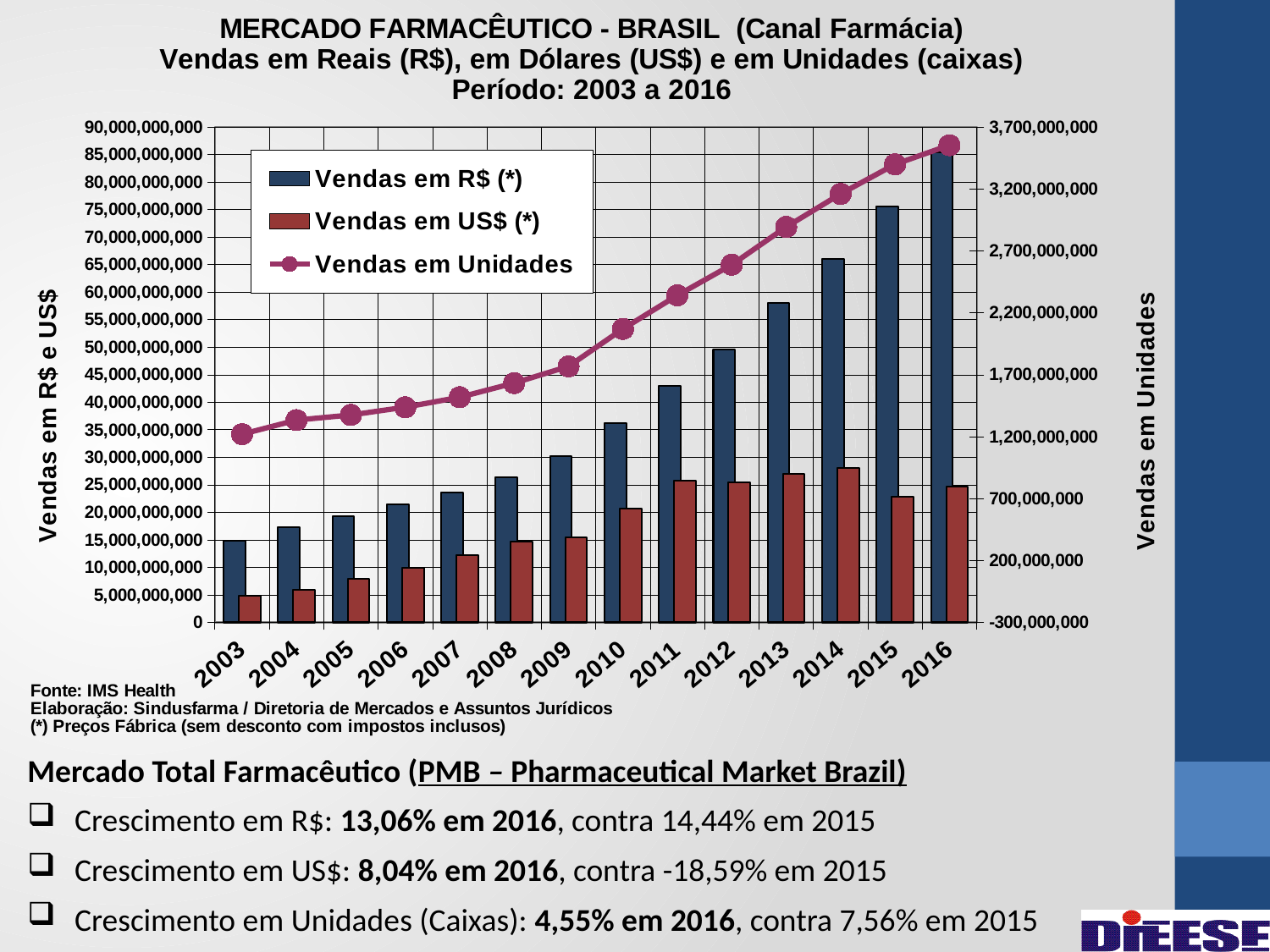
Is the value for Vendas em Unidades in 2003 greater or less than 1,700,000,000? less What kind of chart is shown on the slide? A bar chart combined with a line series Is the value for Vendas em R$ (*) in 2016 greater or less than 80,000,000,000? greater Which year has the lowest value for Vendas em R$ (*)? 2003 Does the Vendas em Unidades line rise or fall from 2003 to 2016? rise How many series does the legend list? 3 Which year has the lowest value for Vendas em US$ (*)? 2003 Which year has the highest value for Vendas em R$ (*)? 2016 What is the title of the right-hand vertical axis? Vendas em Unidades Is the value for Vendas em R$ (*) in 2010 greater or less than 40,000,000,000? less How many years are shown on the x axis? 14 Which is larger in 2014: Vendas em US$ (*) in 2014 or Vendas em US$ (*) in 2015? Vendas em US$ (*) in 2014